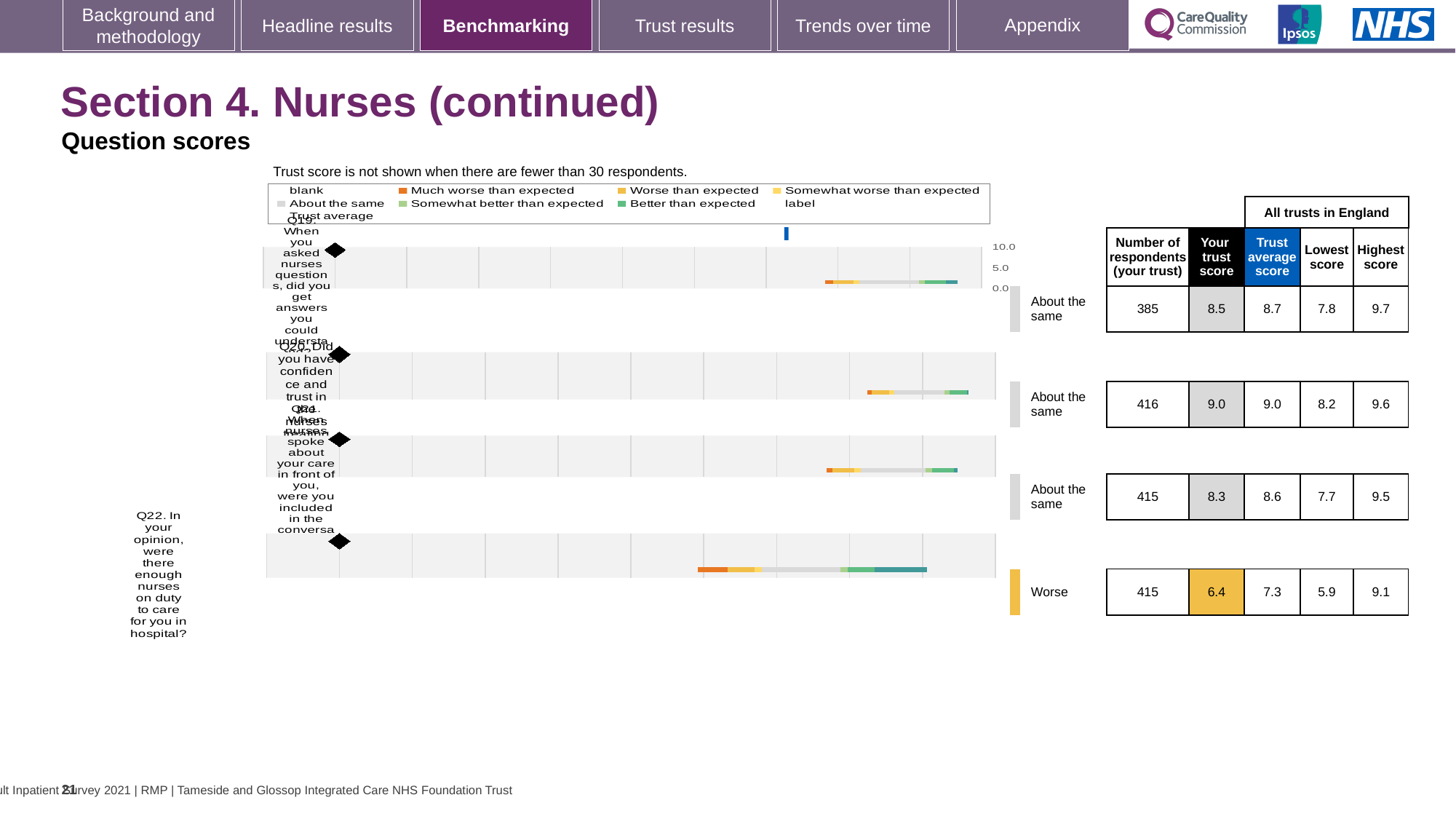
What is the difference between the trust average score and the trust score for Q22? 0.9 What is the trust score for Q22 (enough nurses on duty)? 6.4 What is the highest score across all trusts in England for Q22? 9.1 For Q19, which is larger: the trust score or the trust average score? trust average score How many respondents answered Q19 at the trust? 385 What colour does the legend use for 'Much worse than expected'? orange How many questions (categories) are plotted in the chart? 4 What kind of chart is shown on the slide? bar chart Which question has the highest trust score? Q20 Which question has the lowest trust score? Q22 What is the trust score for Q20 (confidence and trust in nurses)? 9.0 What benchmark category is shown for Q22? Worse